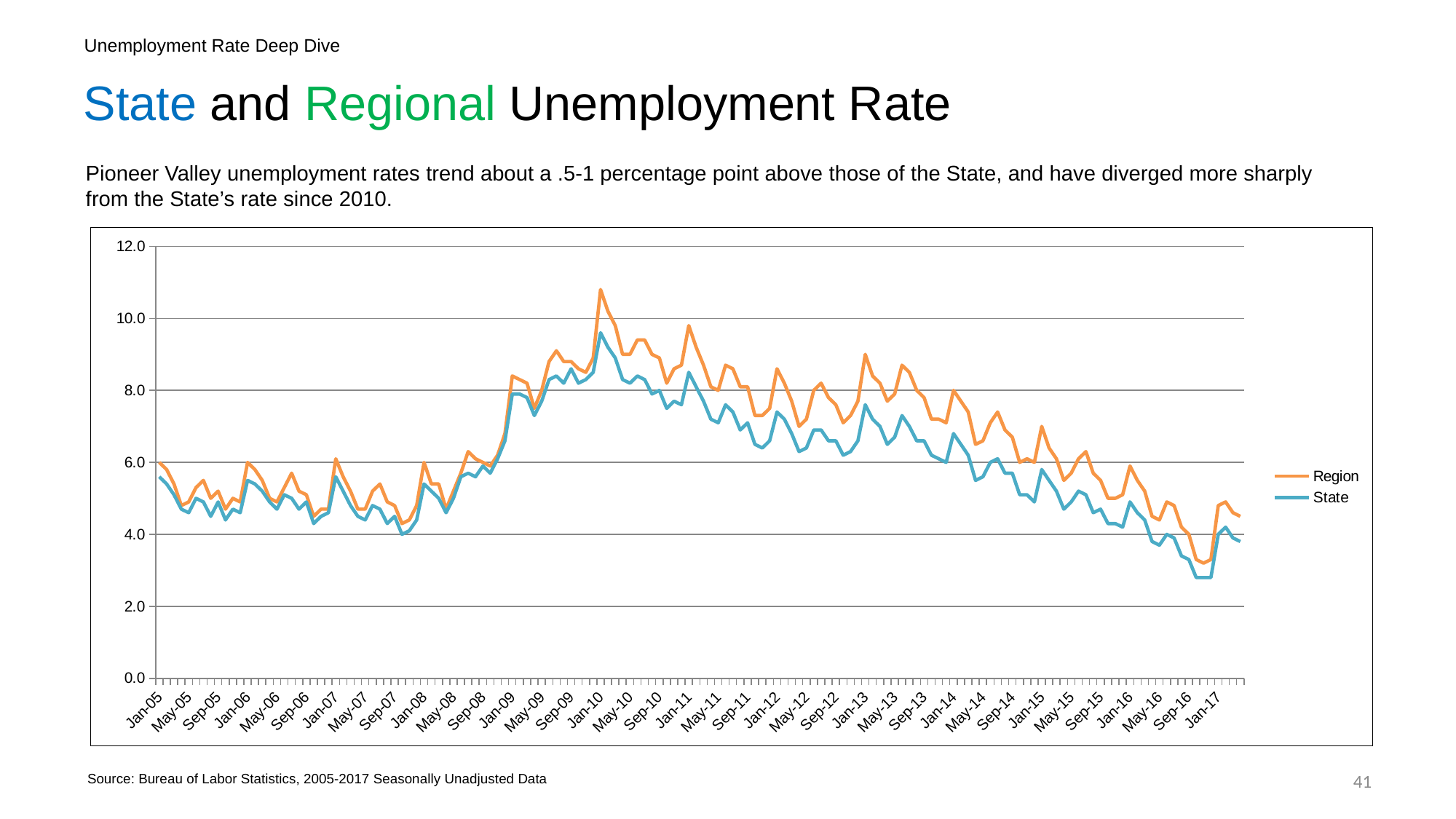
Which series reaches the highest peak on the chart? Region Is the State value at Sep-16 greater or less than 4.0? less Is the Region value at Jan-11 greater or less than 8.0? greater Which series is drawn in blue? State Which series reaches the lowest point on the chart? State Do the unemployment rates generally rise or fall from Jan-10 to Jan-17? fall What kind of chart is shown on the slide? line chart How many series does the legend list? 2 At Jan-13, which series has the higher value, Region or State? Region Which series is drawn in orange? Region Is the peak value of the Region series around Jan-10 greater or less than 10.0? greater